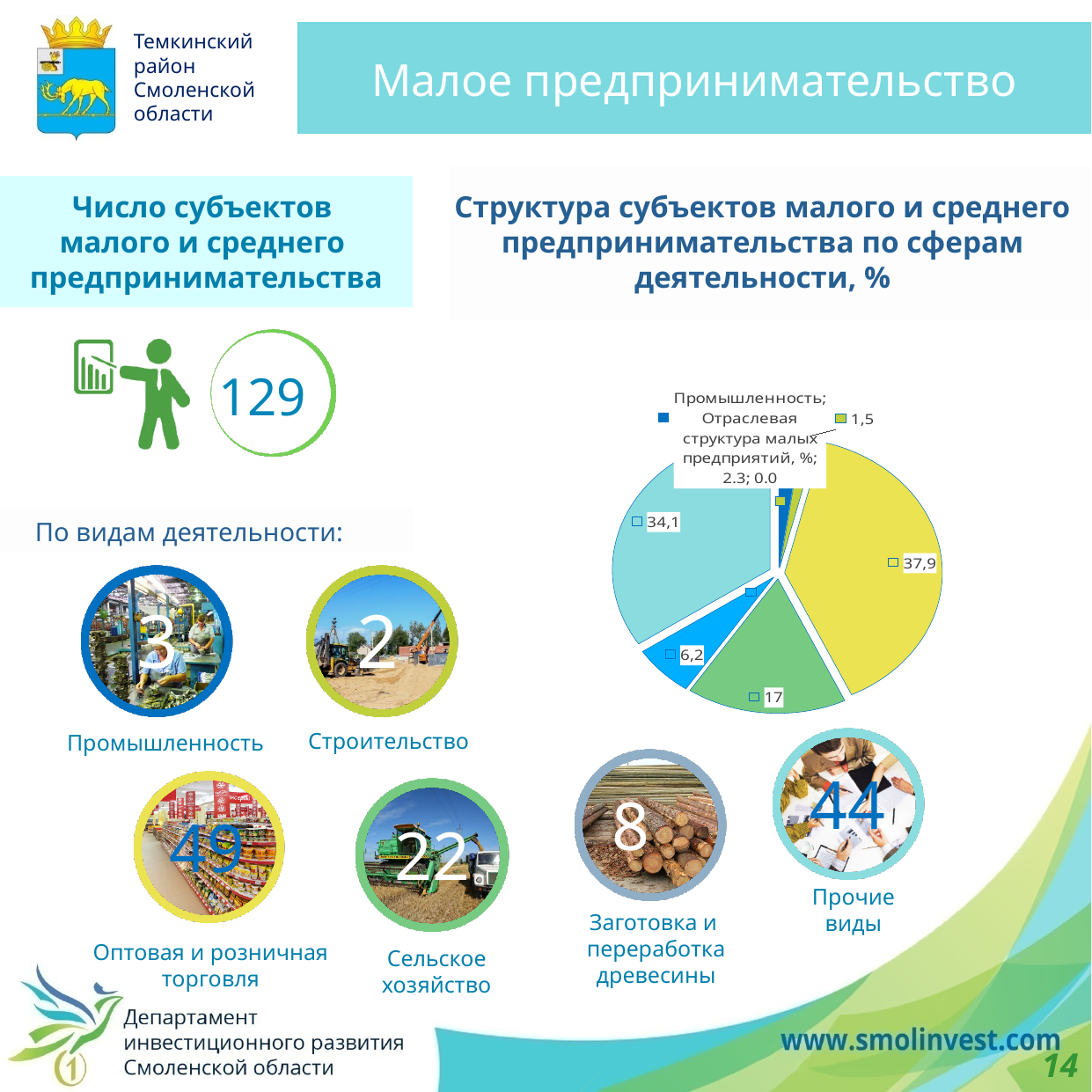
In the pie chart, what value is labelled on the dark blue slice? 6,2 In the pie chart, which is larger: the slice labelled 34,1 or the slice labelled 37,9? 37,9 What kind of chart is shown under the title "Структура субъектов малого и среднего предпринимательства по сферам деятельности, %"? pie chart In the pie chart, is the yellow slice larger or smaller than the light blue slice? larger What is the title of the pie chart on the slide? Структура субъектов малого и среднего предпринимательства по сферам деятельности, % In the pie chart, what is the difference between the slices labelled 37,9 and 34,1? 3,8 In the pie chart, what is the difference between the slices labelled 17 and 6,2? 10,8 In the pie chart, what is the value of the largest slice? 37,9 In what unit are the values of the pie chart expressed, according to its title? % In the pie chart, what value is labelled on the green slice? 17 In the pie chart, what value is labelled on the light blue slice? 34,1 In the pie chart, which is larger: the green slice or the dark blue slice? the green slice (17)